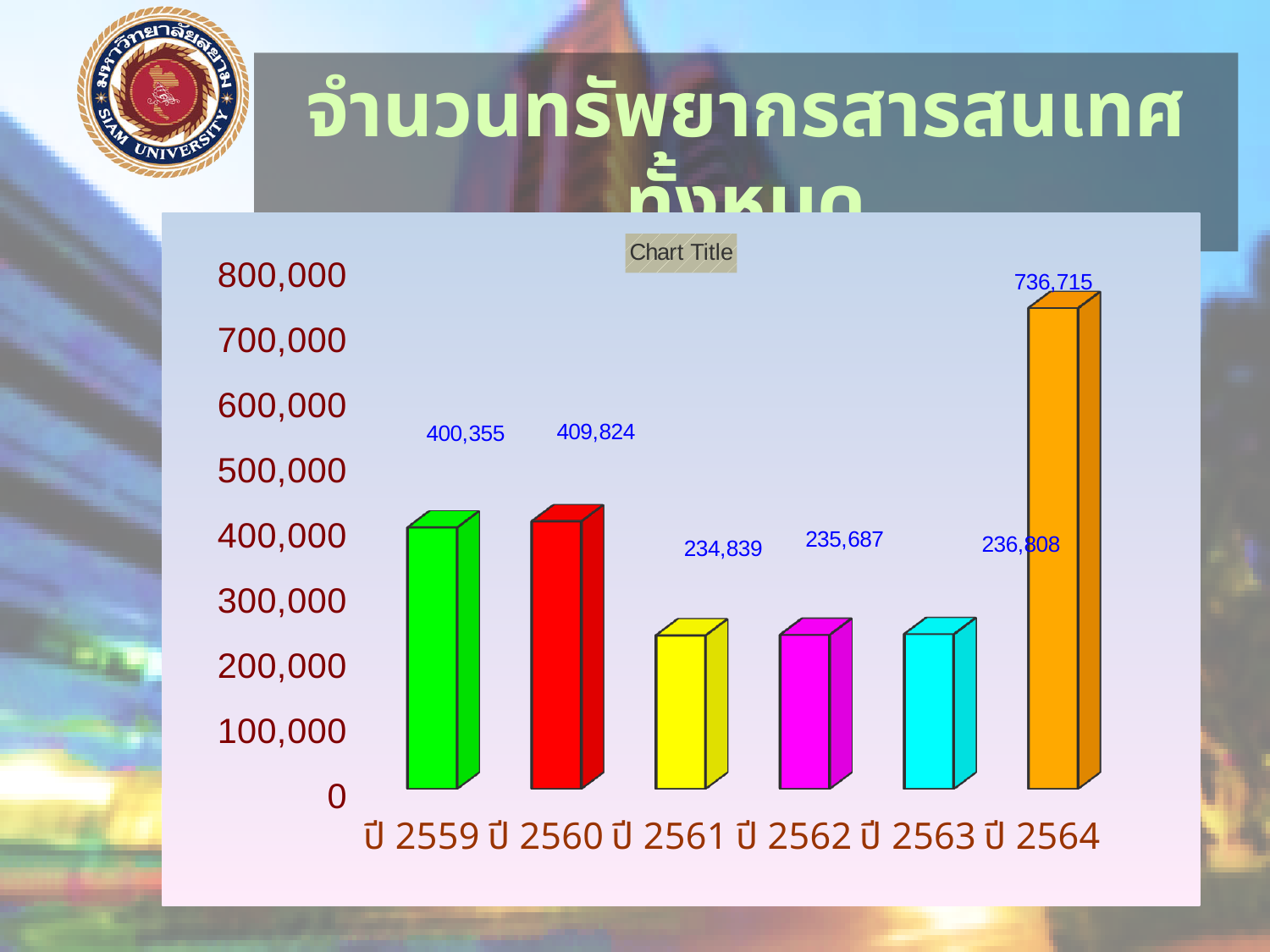
What is the value for ปี 2564? 736,715 How many years are shown on the x axis? 6 Which is larger, the value for ปี 2560 or the value for ปี 2563? ปี 2560 What is the difference between the values for ปี 2564 and ปี 2560? 326,891 Which year has the lowest value? ปี 2561 What is the difference between the values for ปี 2560 and ปี 2559? 9,469 Is the value for ปี 2562 greater or less than 300,000? less Which year has the highest value? ปี 2564 What kind of chart is shown on the slide? bar chart What is the value for ปี 2559? 400,355 What is the value for ปี 2561? 234,839 What is the title printed inside the chart area? Chart Title